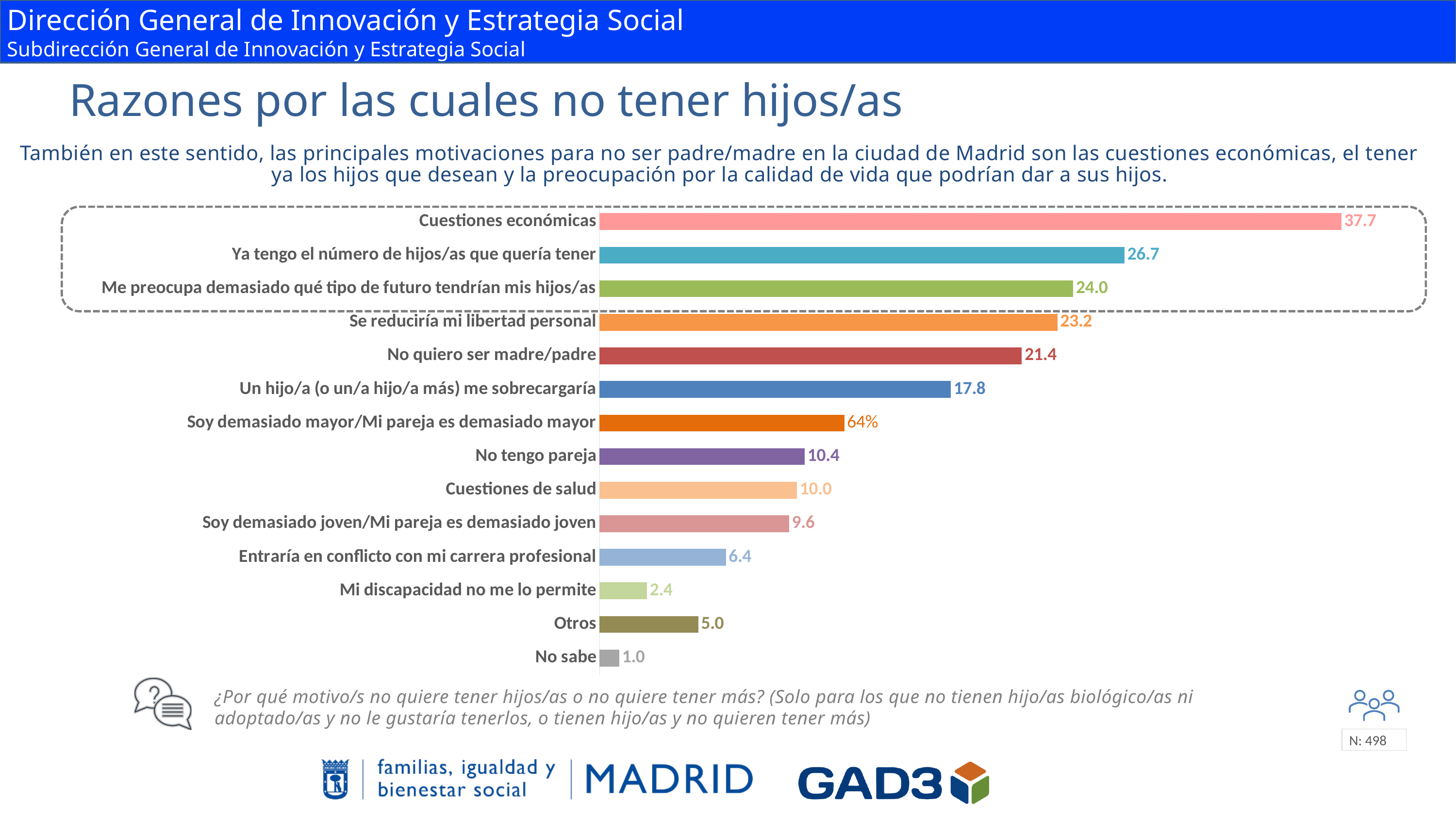
How many categories are shown in the chart? 14 What is the value for "No quiero ser madre/padre"? 21.4 Which category has the lowest value? No sabe What is the value for "Entraría en conflicto con mi carrera profesional"? 6.4 Which is larger, the value for "Otros" or the value for "Mi discapacidad no me lo permite"? Otros How many categories are enclosed in the dashed box at the top of the chart? 3 What is the difference between the values for "No tengo pareja" and "Cuestiones de salud"? 0.4 What is the difference between the values for "Cuestiones económicas" and "Ya tengo el número de hijos/as que quería tener"? 11.0 Which category has the highest value? Cuestiones económicas What kind of chart is shown on the slide? bar chart What is the value for "Ya tengo el número de hijos/as que quería tener"? 26.7 What is the value for "Cuestiones económicas"? 37.7